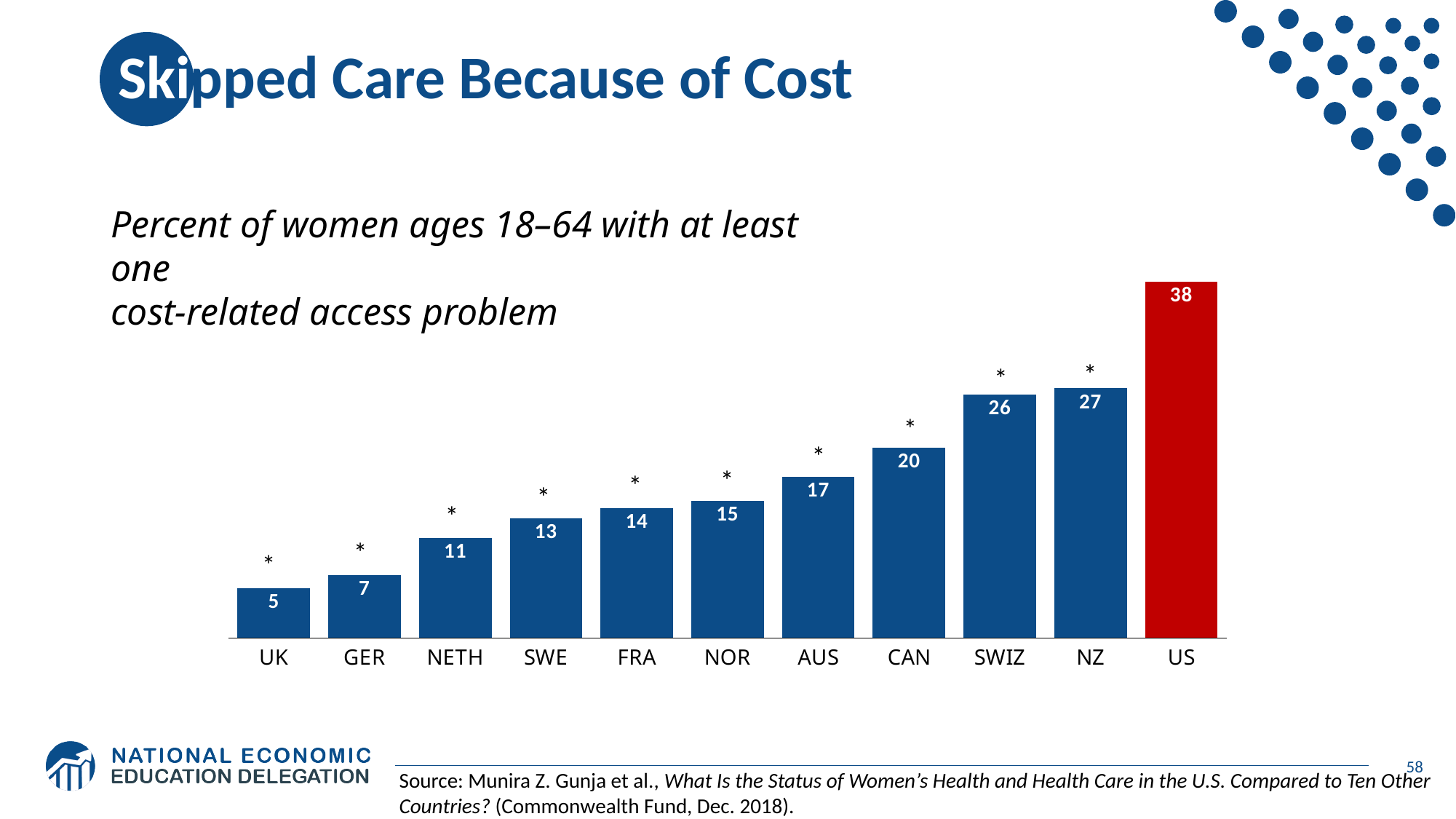
Which bar is coloured red rather than blue? US How many countries are shown in the chart? 11 Which has a larger value, AUS or FRA? AUS What is the value for Canada (CAN)? 20 Which country has the lowest value? UK What is the difference between the values for SWIZ and NETH? 15 What is the value for the US? 38 Which country has the highest value? US What is the value for Germany (GER)? 7 What is the difference between the values for the US and NZ? 11 Do the values rise or fall from left to right along the x axis? Rise What kind of chart is shown on the slide? Bar chart